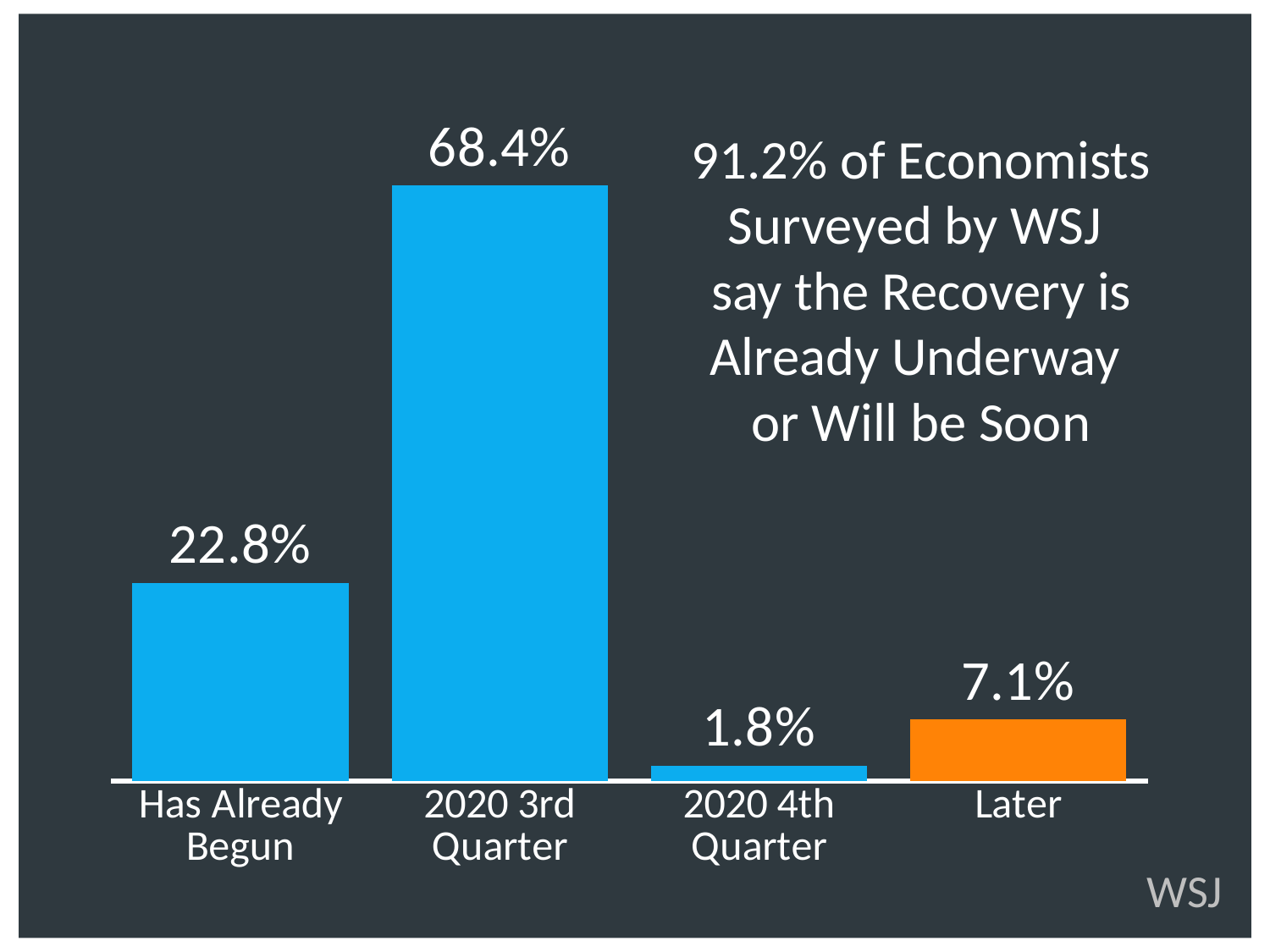
What is the value for "2020 3rd Quarter"? 68.4% What is the value for "Later"? 7.1% Which bar is coloured orange rather than blue? Later Which category has the lowest value? 2020 4th Quarter What is the difference between the values for "2020 3rd Quarter" and "Has Already Begun"? 45.6% What is the value for "2020 4th Quarter"? 1.8% What is the value for "Has Already Begun"? 22.8% Which category has the highest value? 2020 3rd Quarter What is the difference between the values for "Later" and "2020 4th Quarter"? 5.3% Which is larger, the value for "Later" or the value for "2020 4th Quarter"? Later What kind of chart is shown on the slide? Bar chart How many categories are shown in the chart? 4